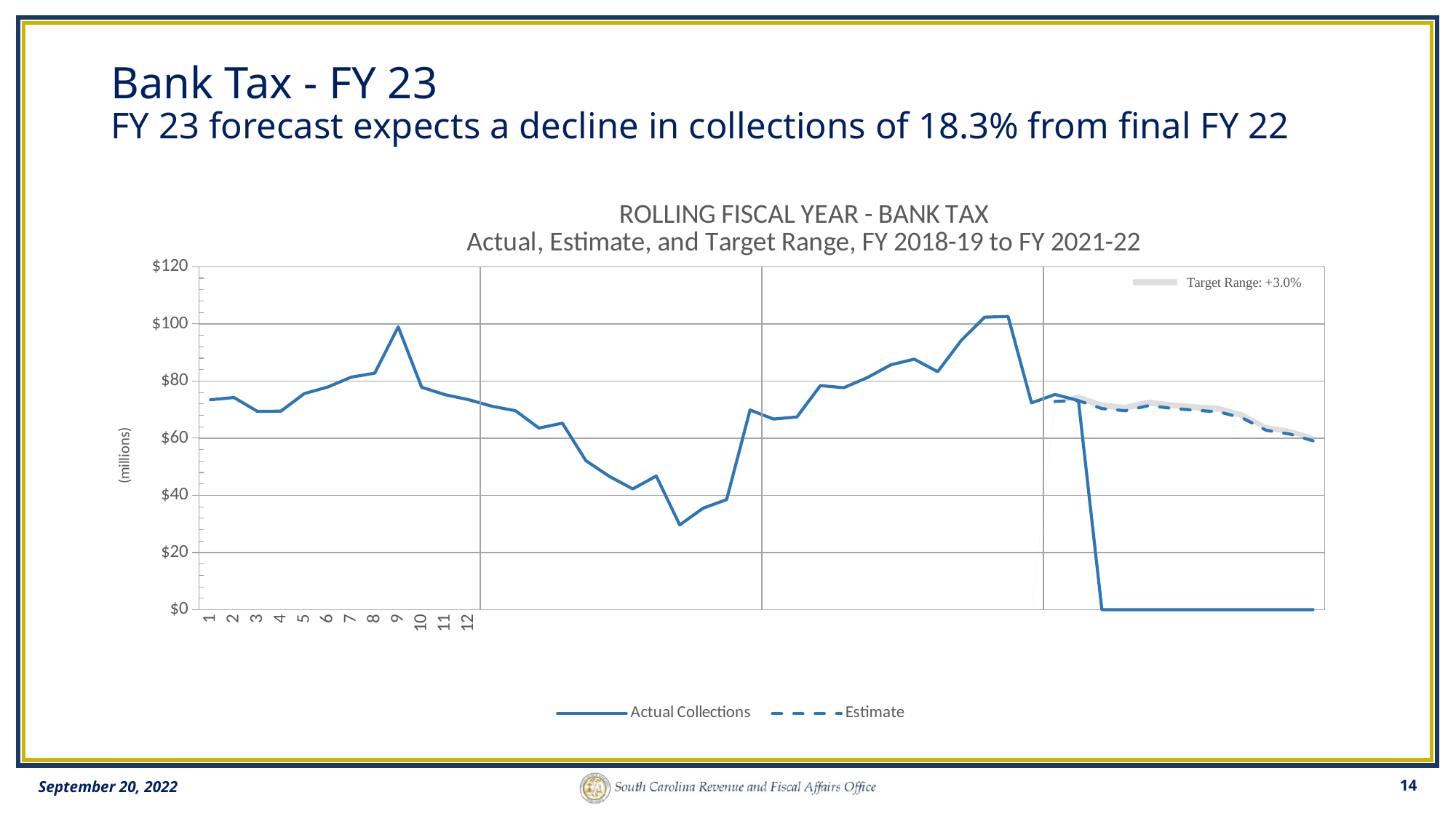
Is the Actual Collections value at month 9 of the first fiscal year greater or less than $80? greater What are the two series named in the chart legend? Actual Collections and Estimate Is the Actual Collections value at month 3 of the first fiscal year greater or less than $80? less What is the title of the chart? ROLLING FISCAL YEAR - BANK TAX Actual, Estimate, and Target Range, FY 2018-19 to FY 2021-22 Is the Actual Collections value at month 1 of the first fiscal year greater or less than $80? less Does the Actual Collections line rise or fall from month 9 to month 12 of the first fiscal year? fall Which is larger for Actual Collections in the first fiscal year: the value at month 9 or the value at month 12? month 9 How many series does the chart legend list? 2 Does the Actual Collections line rise or fall from month 4 to month 8 of the first fiscal year? rise What kind of chart is shown on the slide? line chart How many month labels are shown on the x axis? 12